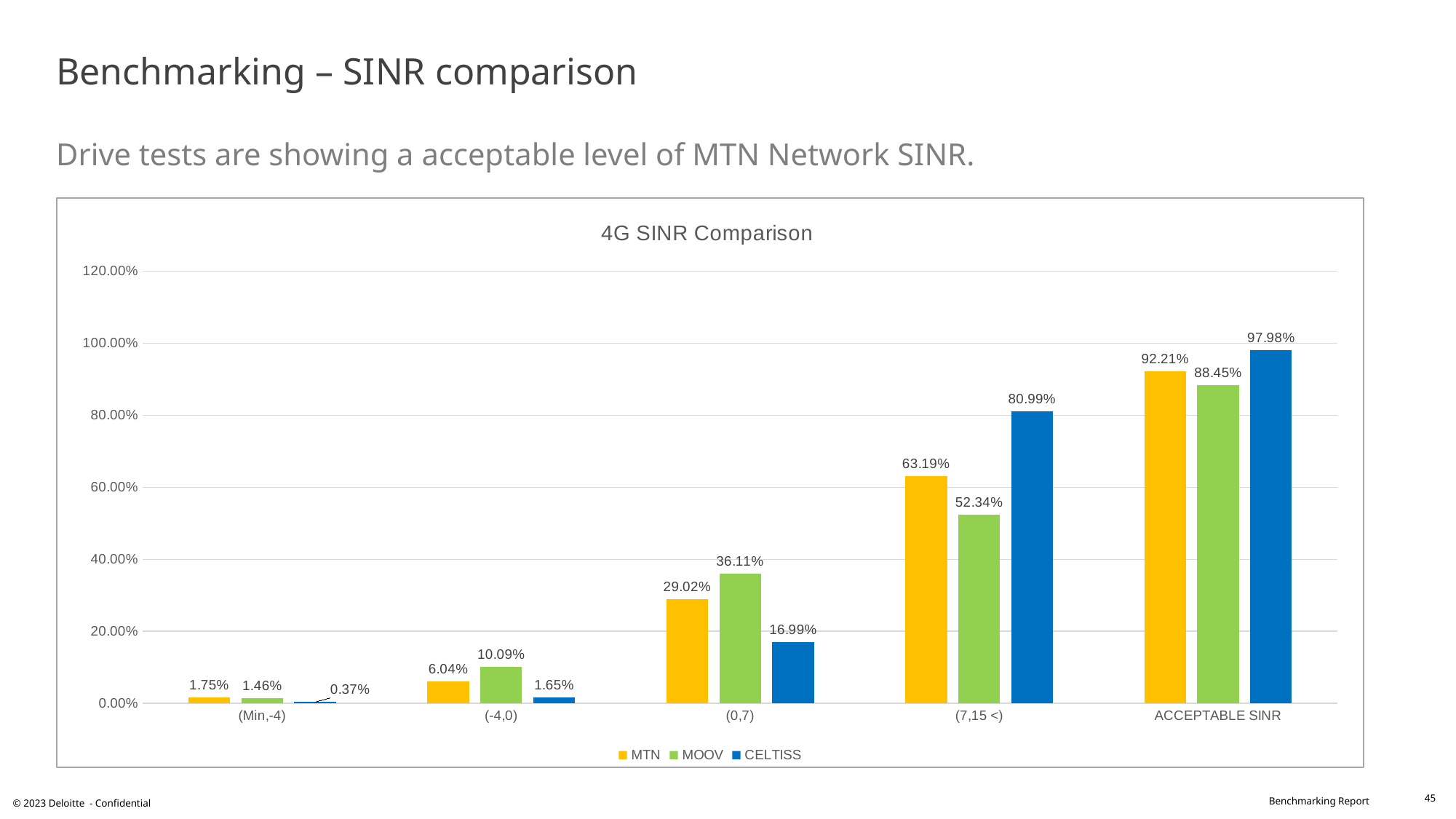
What type of chart is shown on the slide? Bar chart How many categories are shown on the x axis? 5 What is the value for MTN in the (7,15 <) category? 63.19% Which series has the highest value in the (7,15 <) category? CELTISS What is the value for CELTISS in the ACCEPTABLE SINR category? 97.98% What is the value for CELTISS in the (Min,-4) category? 0.37% Which series has the lowest value in the (-4,0) category? CELTISS Is the value for CELTISS in the (7,15 <) category greater or less than 80.00%? greater What is the value for MOOV in the (0,7) category? 36.11% Which is larger in the (0,7) category: the MTN value or the CELTISS value? MTN How many series does the legend list? 3 What is the difference between the MTN and MOOV values in the ACCEPTABLE SINR category? 3.76%